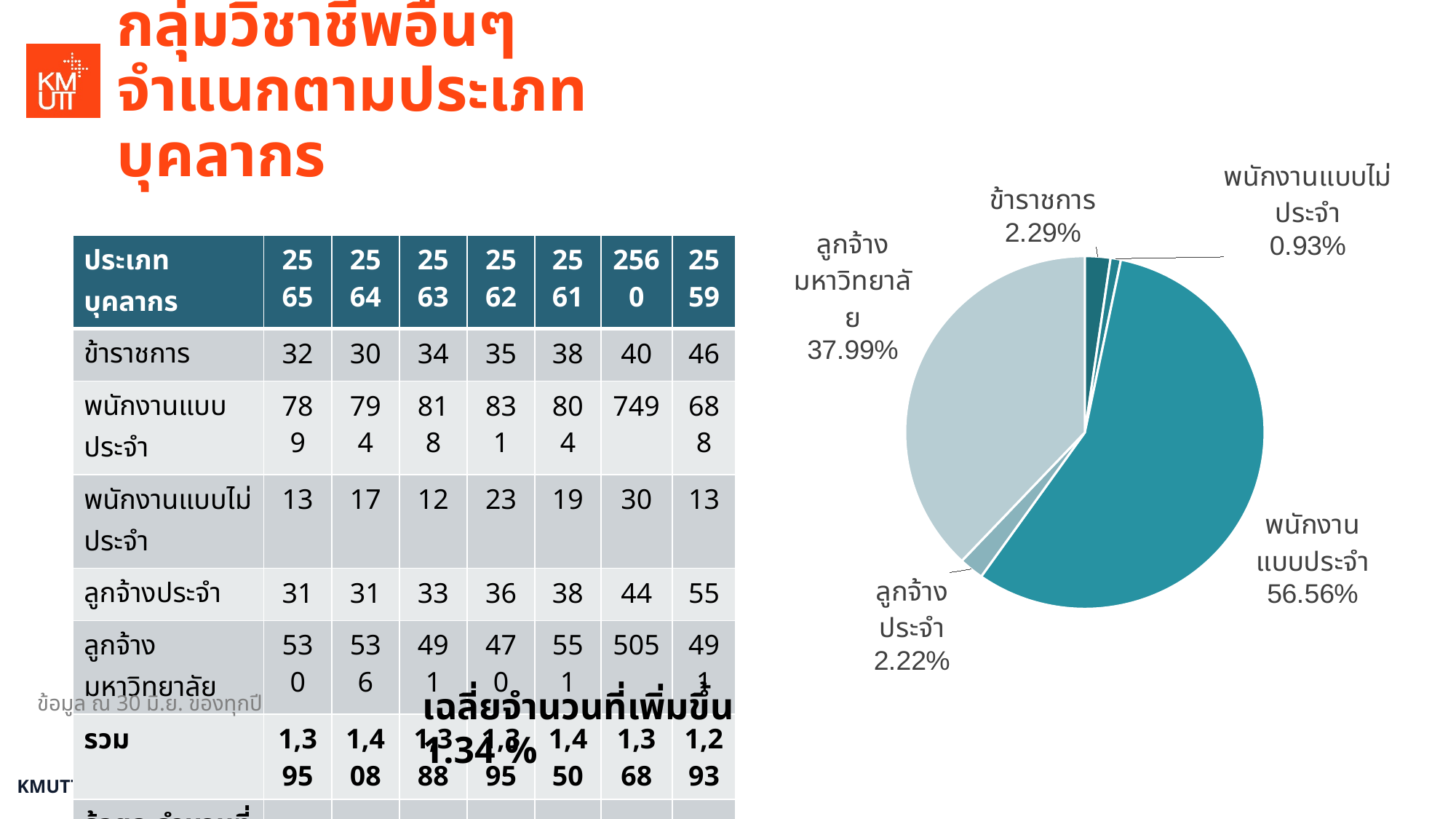
What share of the pie does ลูกจ้างมหาวิทยาลัย have? 37.99% What share of the pie does ลูกจ้างประจำ have? 2.22% What share of the pie does ข้าราชการ have? 2.29% Which category has the largest slice of the pie chart? พนักงานแบบประจำ How many slices does the pie chart have? 5 Which category has the smallest slice of the pie chart? พนักงานแบบไม่ประจำ What is the combined share of ข้าราชการ and ลูกจ้างประจำ in the pie chart? 4.51% In the pie chart, which is larger: the share for ข้าราชการ or the share for พนักงานแบบไม่ประจำ? ข้าราชการ What is the difference in percentage points between the shares of พนักงานแบบประจำ and ลูกจ้างมหาวิทยาลัย in the pie chart? 18.57 What kind of chart is shown on the right side of the slide? pie chart